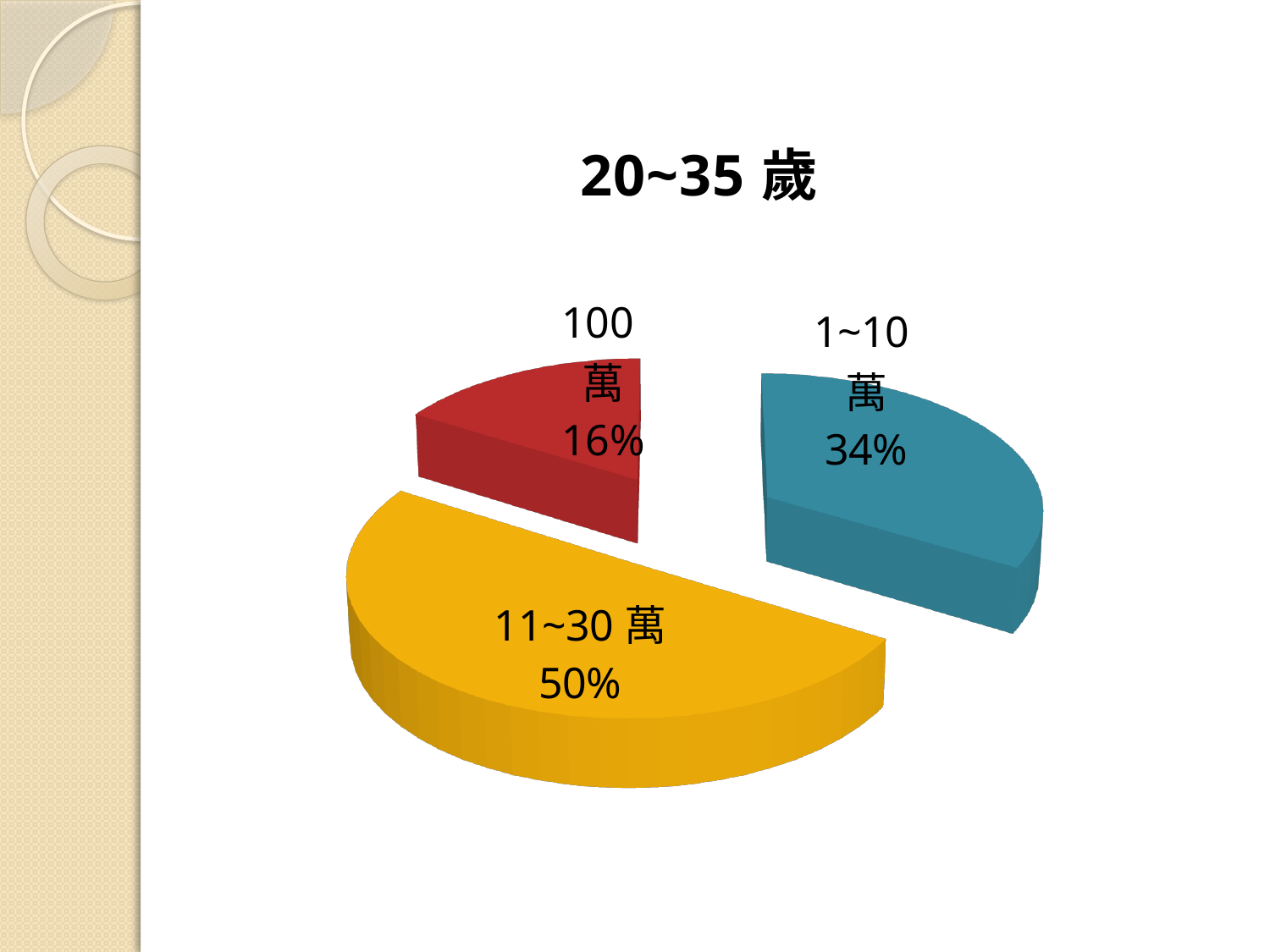
What percentage is shown for the 100 萬 slice? 16% What is the difference in percentage points between the 11~30 萬 slice and the 1~10 萬 slice? 16 Which is larger, the share for 1~10 萬 or the share for 100 萬? 1~10 萬 How many slices does the pie chart have? 3 What colour is the 11~30 萬 slice? yellow What kind of chart is shown on the slide? pie chart What is the title of the pie chart? 20~35 歲 Which category has the smallest share of the pie? 100 萬 What is the difference in percentage points between the 1~10 萬 slice and the 100 萬 slice? 18 What percentage is shown for the 11~30 萬 slice? 50% What percentage is shown for the 1~10 萬 slice? 34% Which category has the largest share of the pie? 11~30 萬